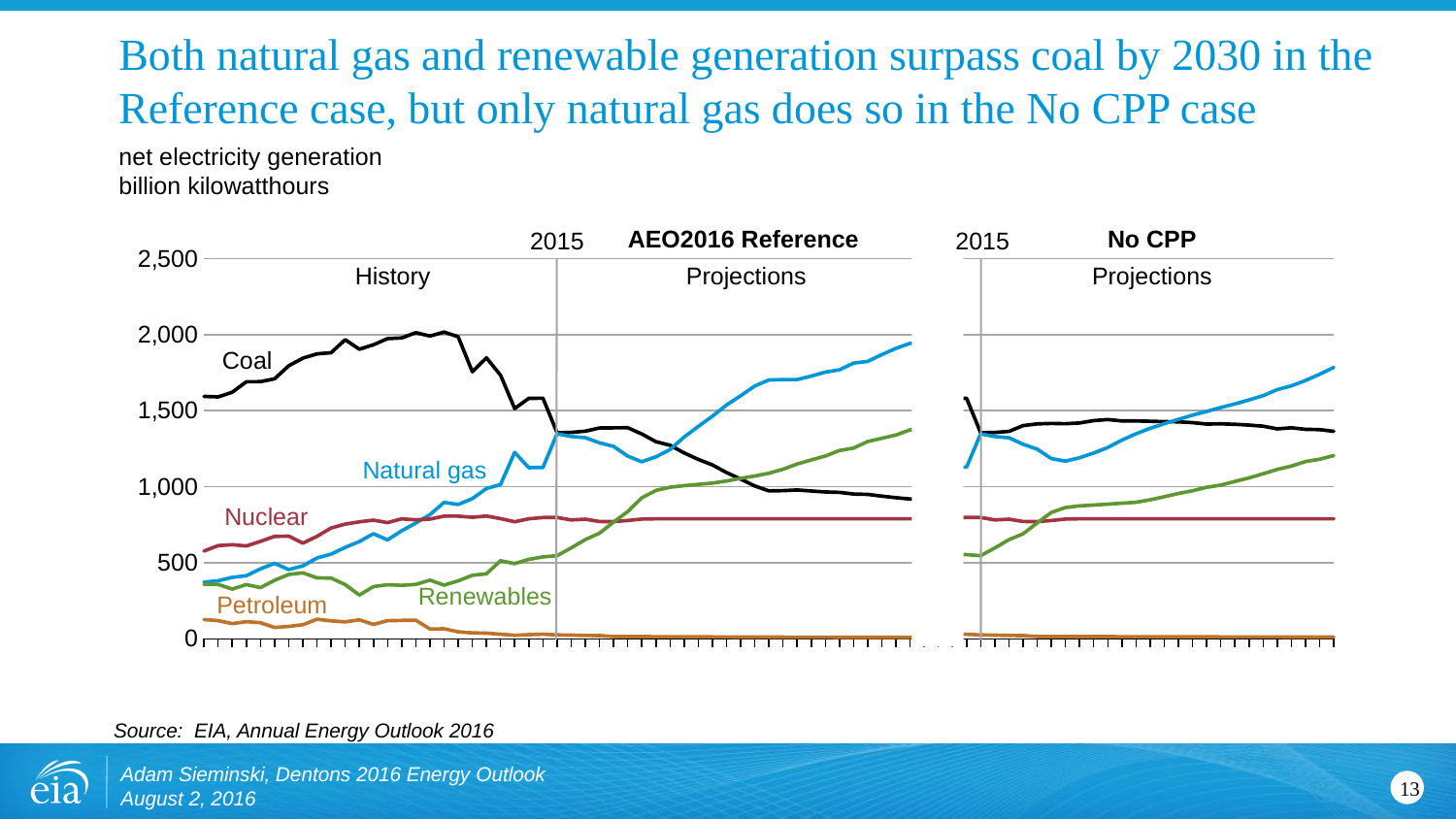
In the No CPP panel, is the value for coal at the end of the projections greater or less than 1,000? greater In the No CPP panel, which is larger at the end of the projections, coal or renewables? Coal In the AEO2016 Reference panel, which series is highest at the end of the projection period? Natural gas In the AEO2016 Reference panel, does coal generation rise or fall over the projection period? fall In the AEO2016 Reference panel, does renewables generation rise or fall over the projection period? rise How many fuel series are labeled on the chart? 5 What kind of chart is shown on the slide? line chart In the No CPP panel, which is larger at the end of the projections, natural gas or coal? Natural gas Which series is the lowest across both panels of the chart? Petroleum In the AEO2016 Reference panel, is the value for coal at the end of the projections greater or less than 1,000? less In the AEO2016 Reference panel, is the value for natural gas at the end of the projections greater or less than 1,500? greater What unit is net electricity generation measured in on the chart? billion kilowatthours